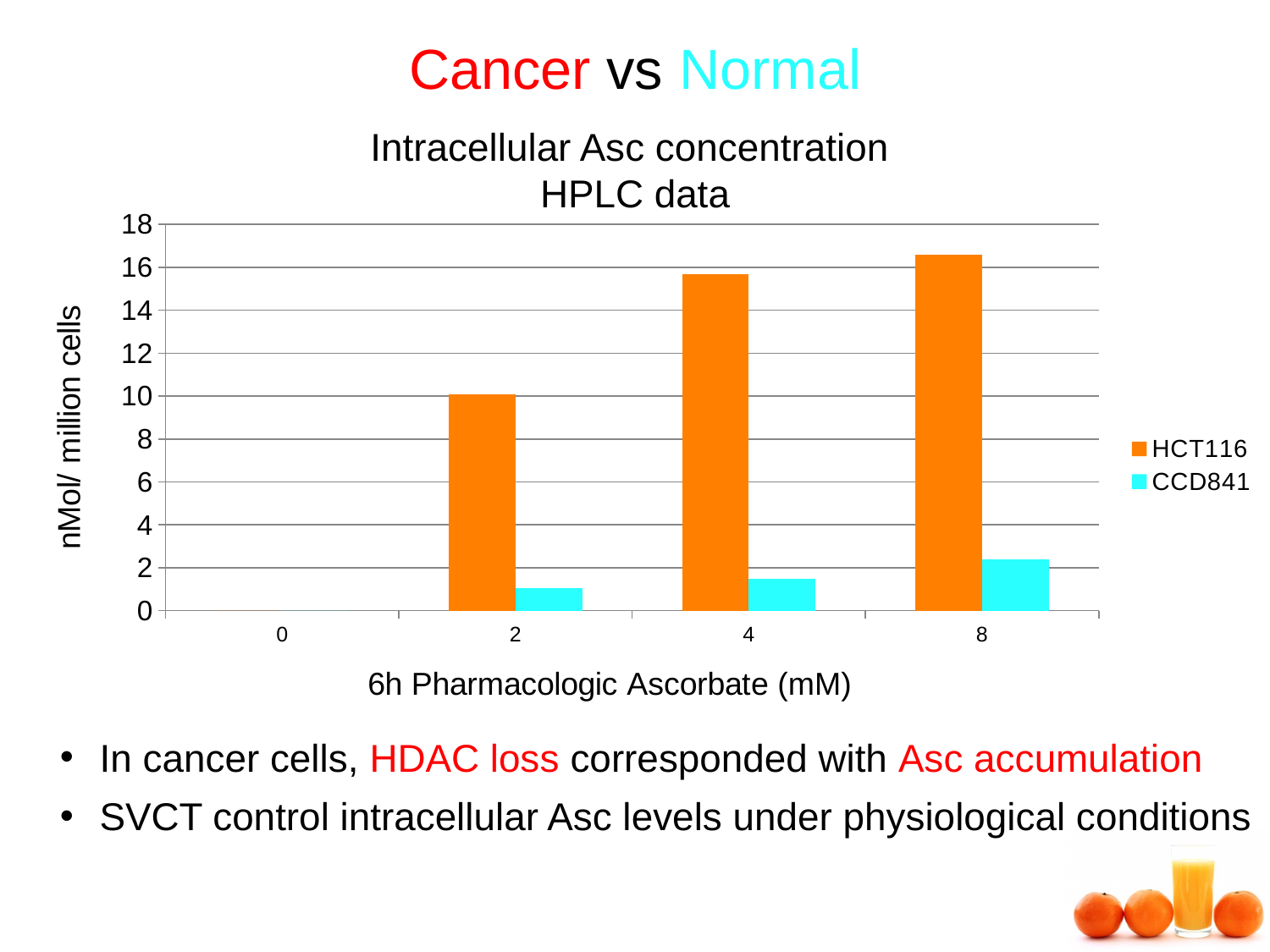
What is the label of the y axis? nMol/ million cells Is the HCT116 value at 4 mM ascorbate greater or less than 14? greater At which ascorbate concentration is the HCT116 value highest? 8 At which ascorbate concentration is the CCD841 value highest? 8 What kind of chart is shown on the slide? bar chart How many ascorbate concentration categories are shown on the x axis? 4 Do the HCT116 values rise or fall as the ascorbate concentration increases from 2 to 8 mM? rise Which two series are listed in the legend? HCT116 and CCD841 At 4 mM ascorbate, which series has the larger value, HCT116 or CCD841? HCT116 Is the CCD841 value at 8 mM ascorbate greater or less than 4? less How many series does the legend list? 2 Is the HCT116 value at 2 mM ascorbate greater or less than 8? greater